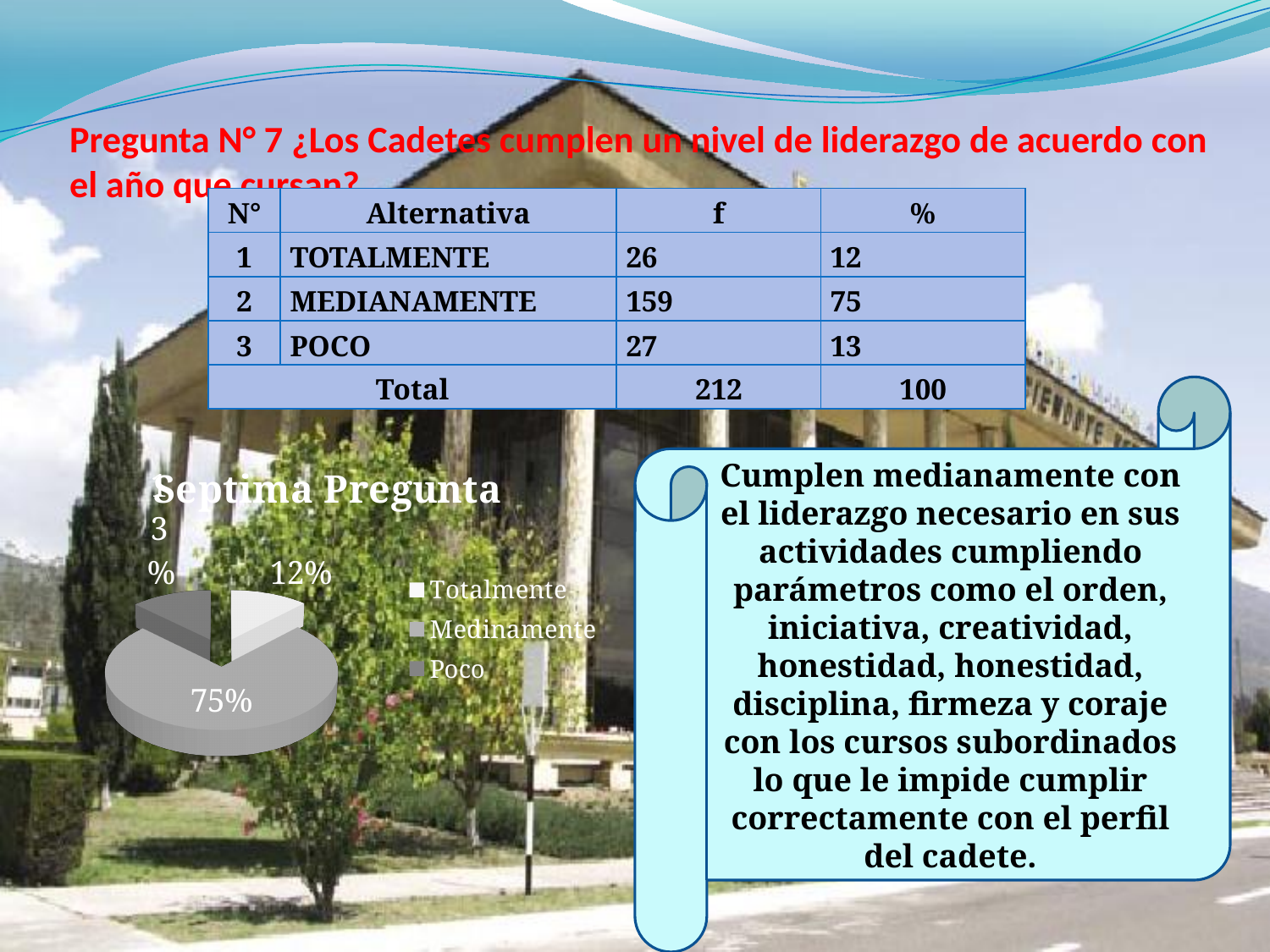
What share of the pie does Medinamente represent? 75% What are the three legend entries of the chart? Totalmente, Medinamente, Poco What kind of chart is shown on the slide? pie chart What is the title of the chart? Septima Pregunta What is the difference between the Medinamente and Totalmente percentages? 63% Which category has the largest slice of the pie? Medinamente How many slices does the pie chart have? 3 Which is larger, the Medinamente slice or the Totalmente slice? Medinamente How many entries does the legend list? 3 What percentage does the Totalmente slice show? 12% What percentage does the Medinamente slice show? 75%